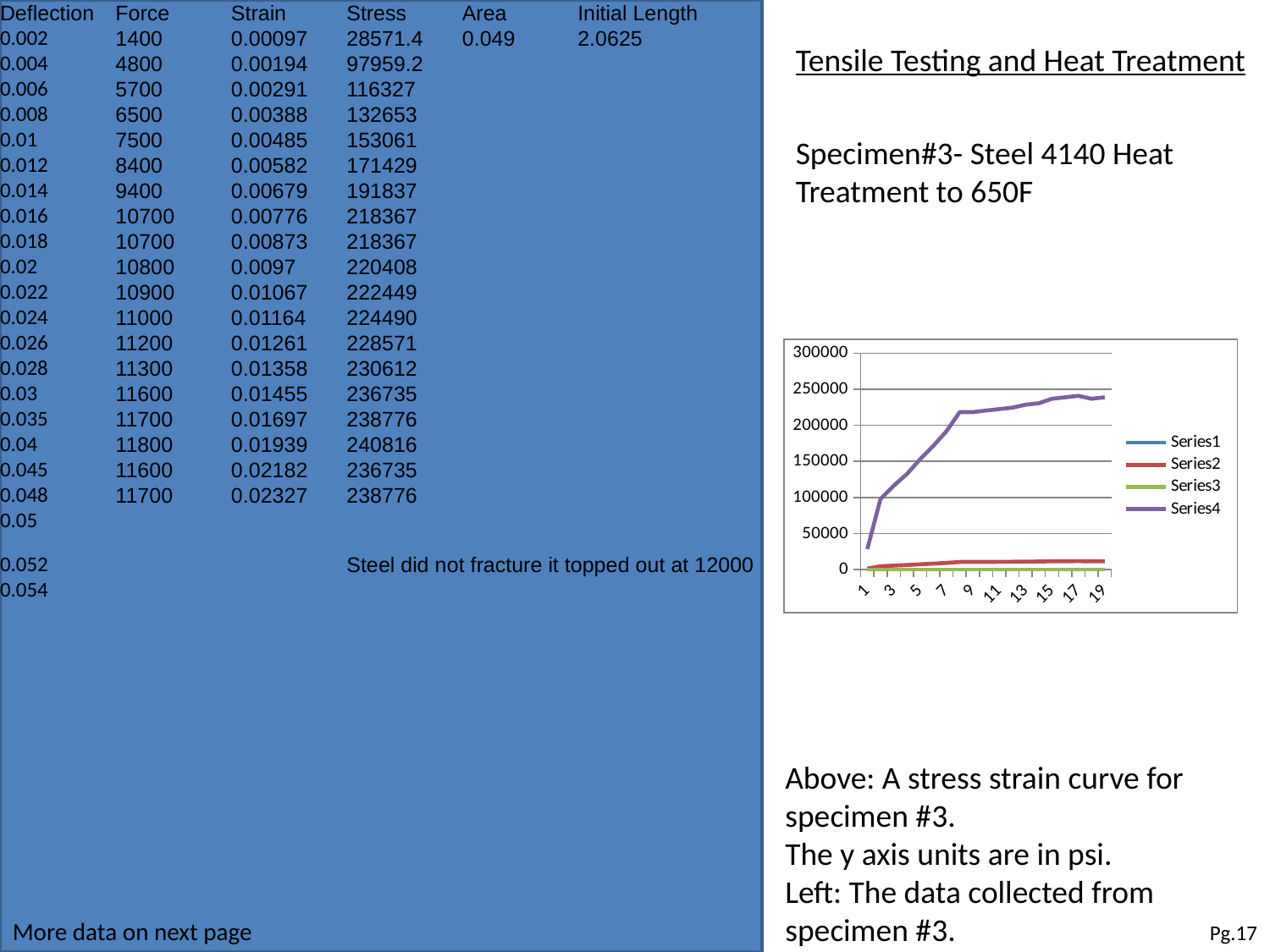
What is the highest value shown on the chart's y axis? 300000 Is the value of Series4 at x = 9 greater or less than 200000? greater Does Series4 generally rise or fall along the x axis? rise At x = 15, which series has the larger value, Series2 or Series4? Series4 Is the value of Series2 at x = 19 greater or less than 50000? less How many series does the chart legend list? 4 What is the last label shown on the chart's x axis? 19 What kind of chart is shown on the slide? line chart Is the value of Series4 at x = 1 greater or less than 50000? less Which series reaches the highest values on the chart? Series4